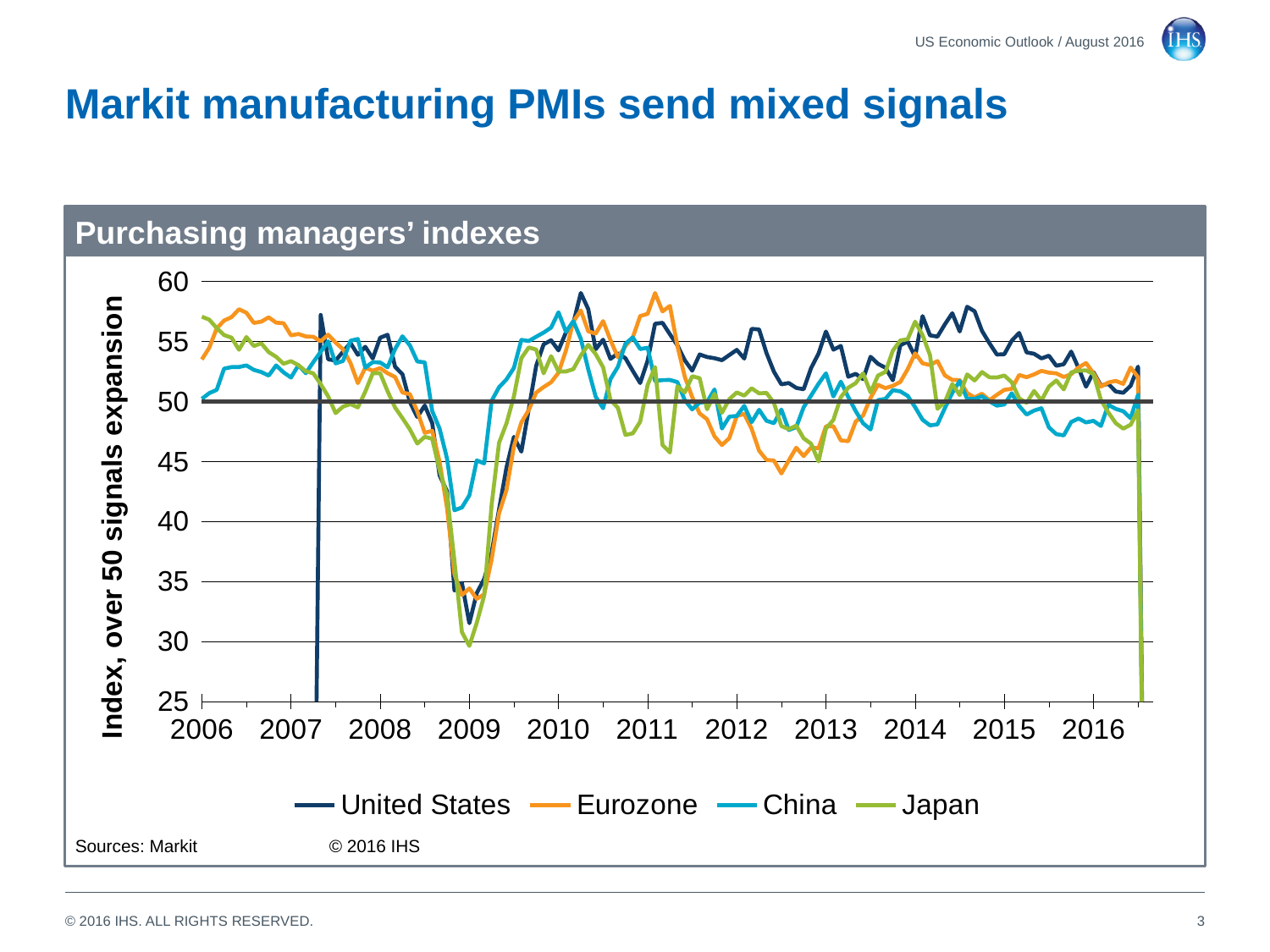
Is the lowest value for the Eurozone in 2012 greater or less than 50? less How many series does the legend list? 4 Does the United States series rise or fall between 2008 and early 2009? fall How many year labels are shown on the horizontal axis? 11 Is the peak value for the United States in 2014 greater or less than 55? greater Is the lowest value for China in 2009 greater or less than 45? less What is the title of the chart? Purchasing managers' indexes Does the Japan series rise or fall between early 2009 and 2010? rise What kind of chart is shown on the slide? line chart What is the label on the vertical axis of the chart? Index, over 50 signals expansion Which series reached the lowest value on the chart during 2009? Japan